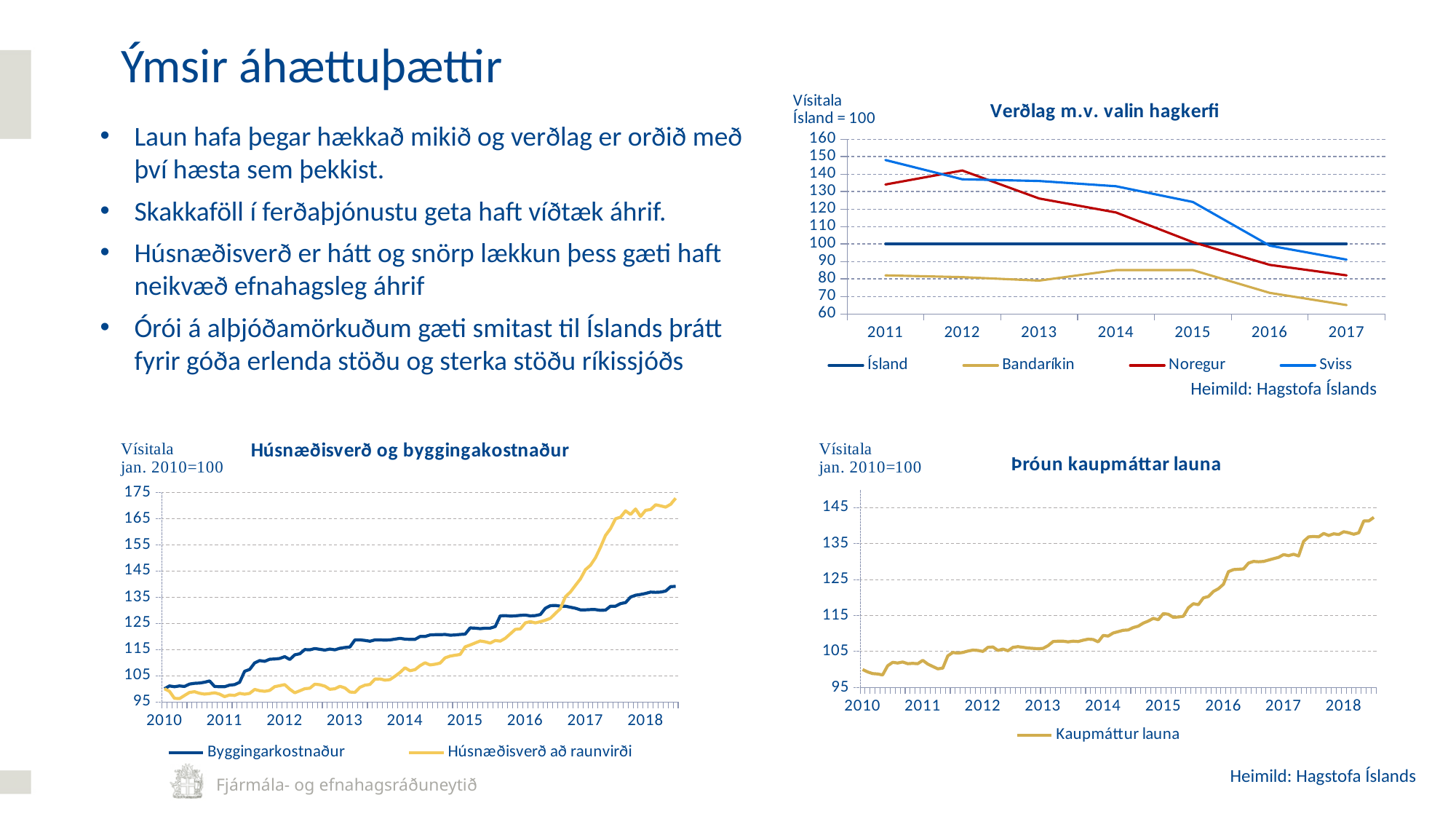
In the chart titled "Verðlag m.v. valin hagkerfi", is the value for Noregur in 2012 greater or less than 130? greater In the chart titled "Verðlag m.v. valin hagkerfi", how many series does the legend list? 4 In the chart titled "Verðlag m.v. valin hagkerfi", which series has the highest value in 2011? Sviss In the chart titled "Húsnæðisverð og byggingakostnaður", is the value for Byggingarkostnaður at the end of 2018 greater or less than 145? less In the chart titled "Verðlag m.v. valin hagkerfi", is the value for Sviss in 2017 greater or less than 100? less In the chart titled "Verðlag m.v. valin hagkerfi", does the Sviss series rise or fall from 2011 to 2017? fall In the chart titled "Verðlag m.v. valin hagkerfi", how many years are shown on the x axis? 7 What kind of chart is "Þróun kaupmáttar launa"? line chart In the chart titled "Húsnæðisverð og byggingakostnaður", which series is higher at the end of 2018? Húsnæðisverð að raunvirði In the chart titled "Verðlag m.v. valin hagkerfi", which series has the lowest value in 2017? Bandaríkin In the chart titled "Verðlag m.v. valin hagkerfi", what is the value for Ísland in 2014? 100